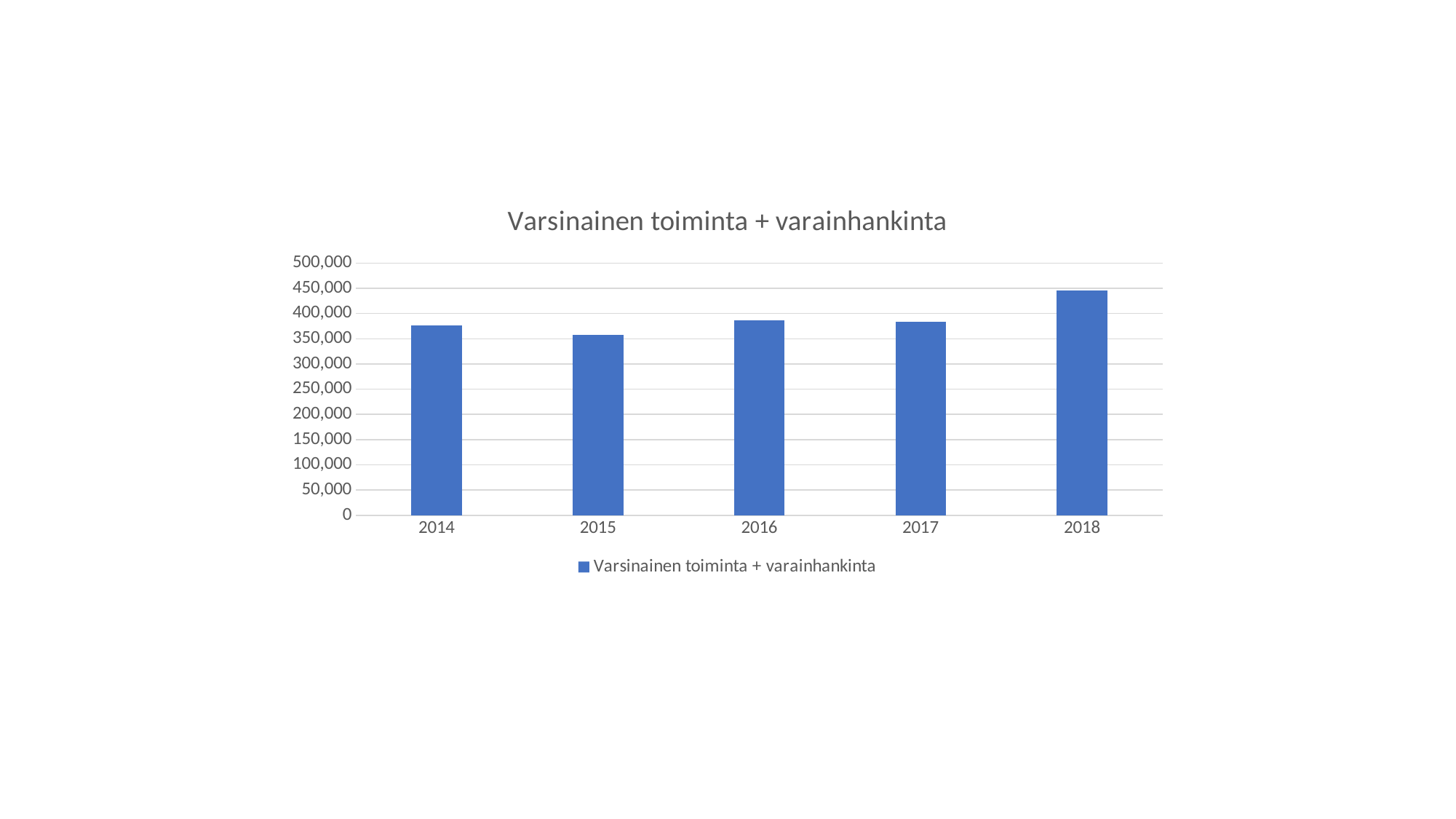
Does the value rise or fall from 2017 to 2018? rise Is the value for 2015 greater or less than 400,000? less Which is larger, the value for 2014 or the value for 2015? 2014 What kind of chart is shown on the slide? bar chart Is the value for 2014 greater or less than 350,000? greater Which year has the highest value? 2018 How many years are shown on the x axis of the chart? 5 Which year has the lowest value? 2015 Is the value for 2018 greater or less than 400,000? greater Which is larger, the value for 2018 or the value for 2016? 2018 What is the title of the chart? Varsinainen toiminta + varainhankinta How many series does the legend list? 1